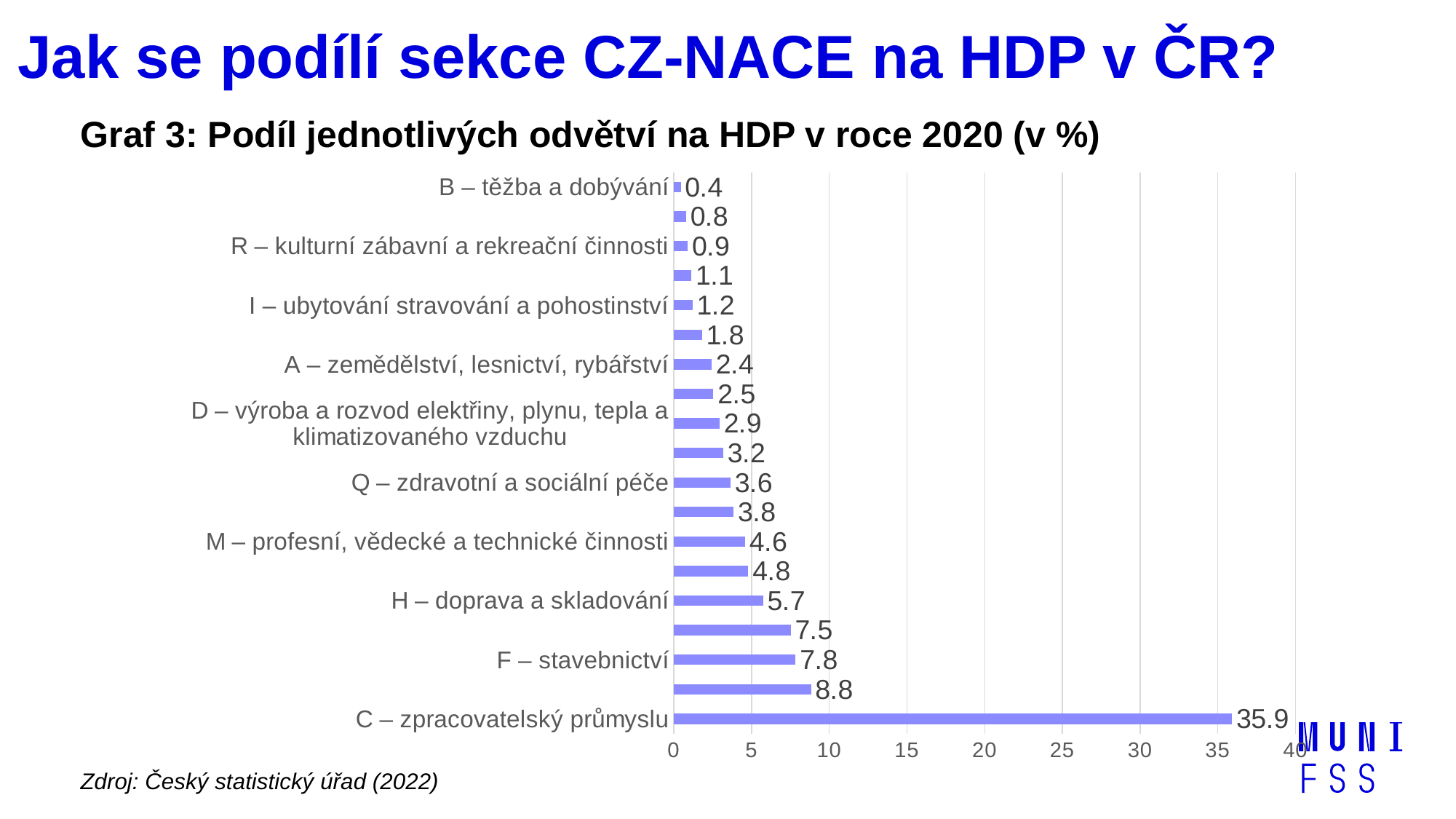
What is the value for F – stavebnictví? 7.8 What is the value for C – zpracovatelský průmyslu? 35.9 What is the value for H – doprava a skladování? 5.7 Which category has the highest value? C – zpracovatelský průmyslu How many bars are plotted in the chart? 19 What is the value for A – zemědělství, lesnictví, rybářství? 2.4 What is the difference between the values for C – zpracovatelský průmyslu and F – stavebnictví? 28.1 What is the source cited below the chart? Český statistický úřad (2022) Which category has the lowest value? B – těžba a dobývání What is the value for Q – zdravotní a sociální péče? 3.6 Which is larger, the value for M – profesní, vědecké a technické činnosti or the value for H – doprava a skladování? H – doprava a skladování What kind of chart is shown on the slide? Bar chart